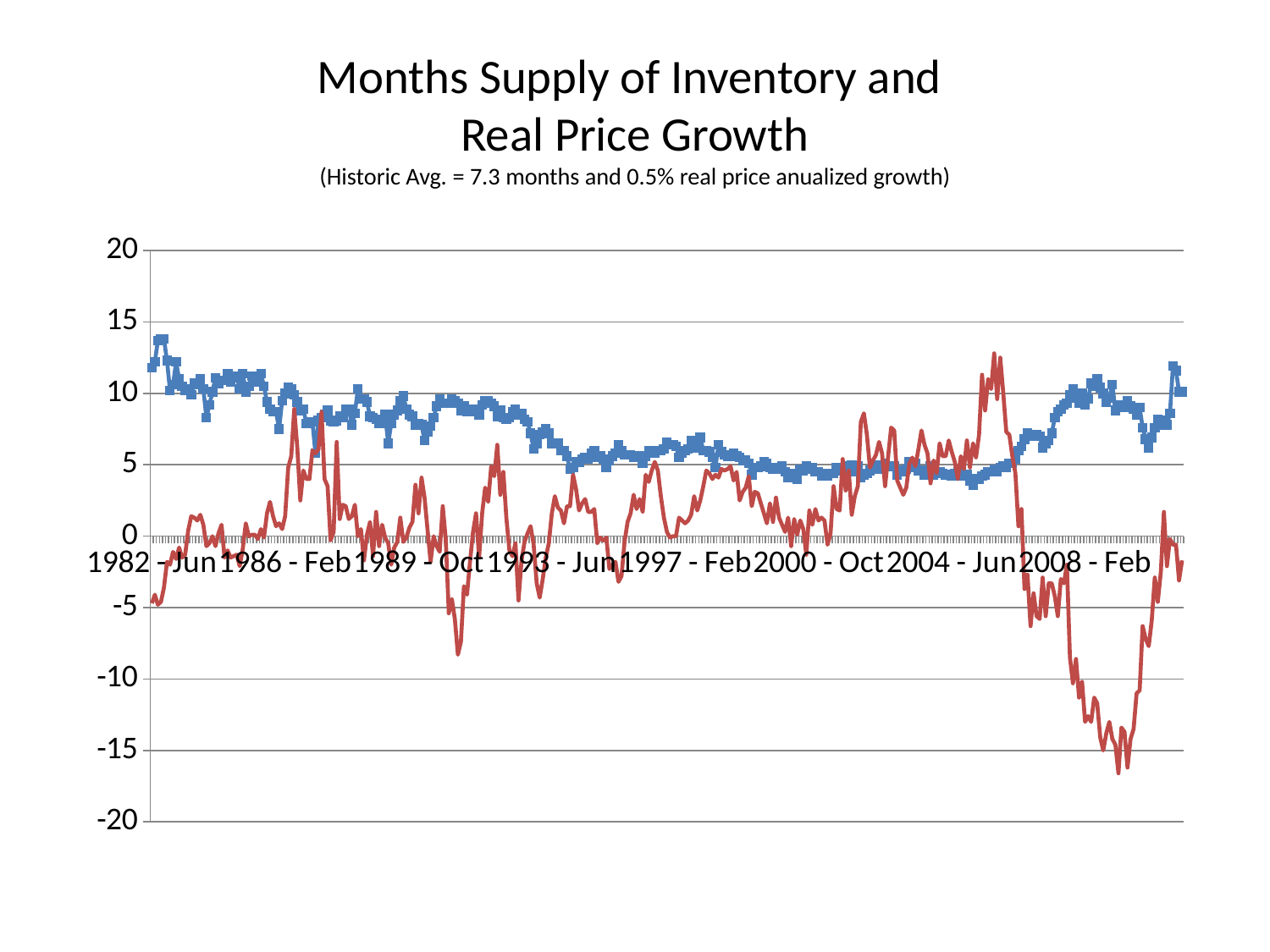
Is the highest point of the red line greater or less than 10? greater What is the highest value shown on the y axis? 20 Is the lowest point of the red line greater or less than -15? less According to the chart subtitle, what is the historic average months supply of inventory? 7.3 months What kind of chart is shown on the slide? line chart What is the title of the chart? Months Supply of Inventory and Real Price Growth Which line reaches the lowest value on the chart, the blue line or the red line? the red line Is the value of the blue line at 2004 - Jun greater or less than 5? less How many date labels are shown along the x axis? 8 How many data series (lines) are plotted on the chart? 2 Does the blue line generally rise or fall between 1982 - Jun and 2004 - Jun? fall